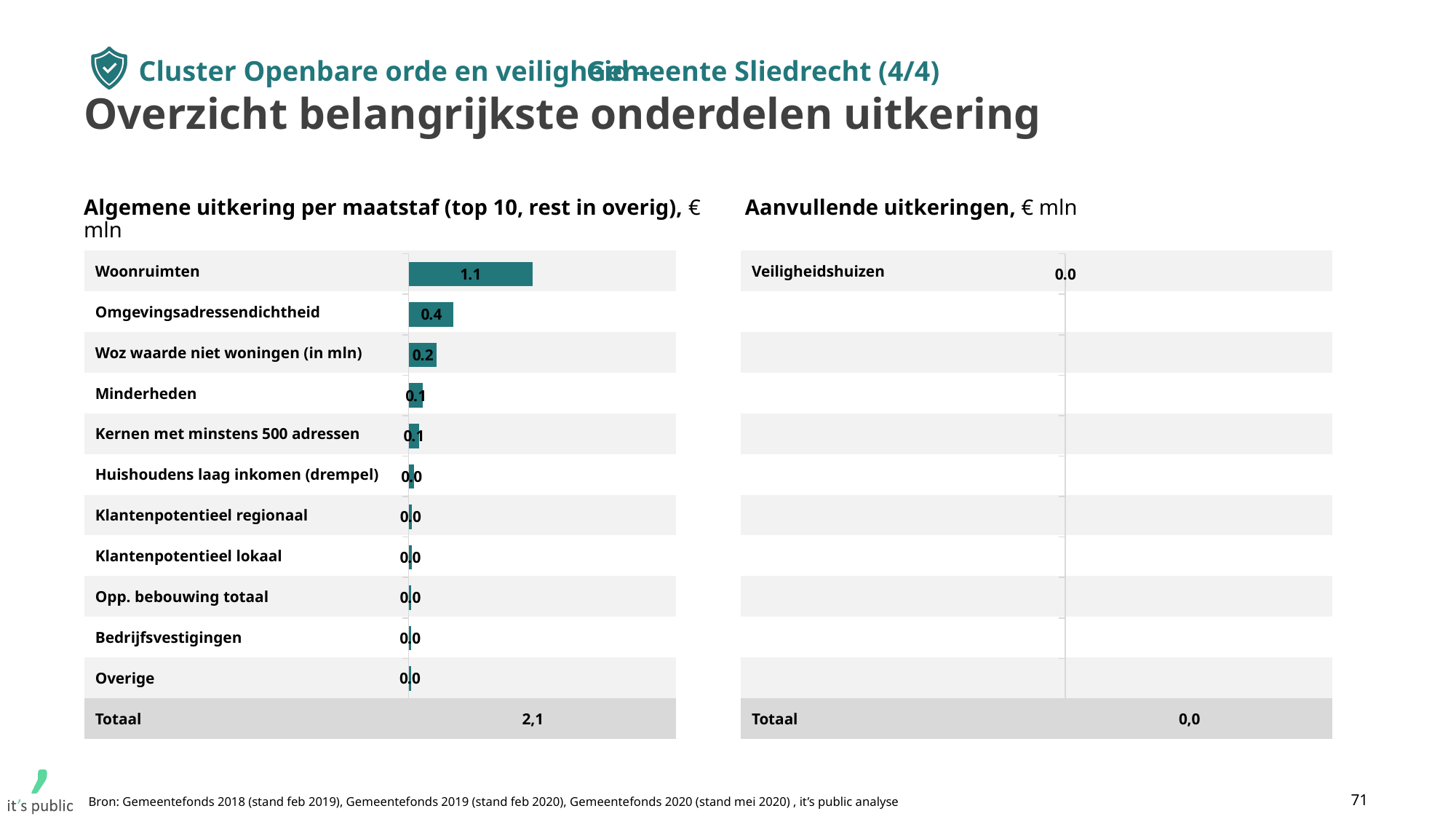
What is the Totaal shown for the chart 'Aanvullende uitkeringen'? 0,0 In the chart 'Algemene uitkering per maatstaf', what is the value for Woonruimten? 1.1 In the chart 'Algemene uitkering per maatstaf', what is the value for Minderheden? 0.1 In the chart 'Algemene uitkering per maatstaf', what is the value for Woz waarde niet woningen (in mln)? 0.2 In the chart 'Algemene uitkering per maatstaf', which is larger: Omgevingsadressendichtheid or Woz waarde niet woningen (in mln)? Omgevingsadressendichtheid In the chart 'Algemene uitkering per maatstaf', what is the value for Omgevingsadressendichtheid? 0.4 What is the Totaal shown for the chart 'Algemene uitkering per maatstaf'? 2,1 In the chart 'Algemene uitkering per maatstaf', which category has the highest value? Woonruimten What type of chart is 'Algemene uitkering per maatstaf'? Bar chart In the chart 'Algemene uitkering per maatstaf', what is the difference between Woonruimten and Omgevingsadressendichtheid? 0.7 In the chart 'Aanvullende uitkeringen', what is the value for Veiligheidshuizen? 0.0 How many categories are shown in the chart 'Algemene uitkering per maatstaf' (excluding the Totaal row)? 11